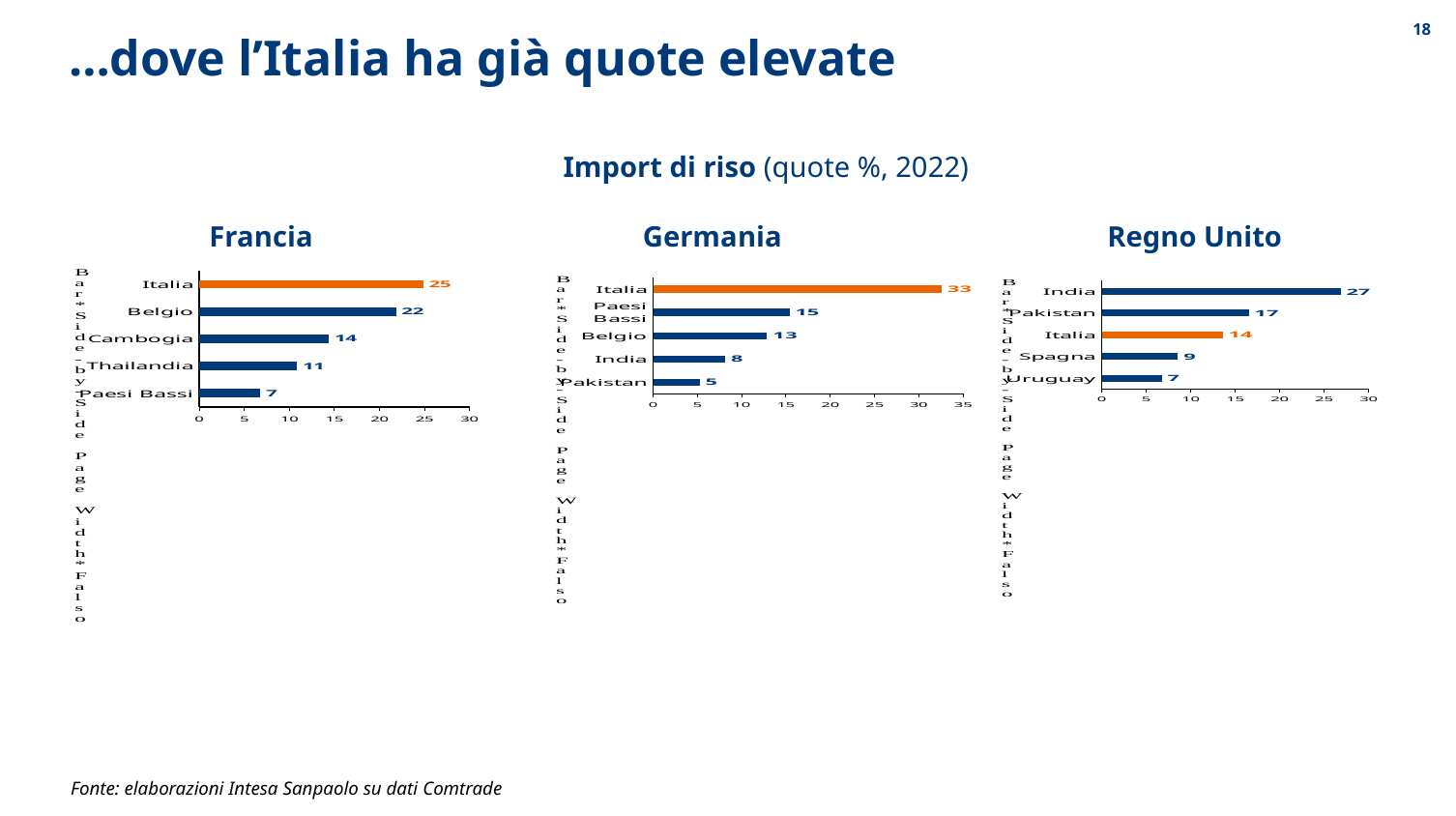
What kind of chart is the Germania chart? Bar chart In the Germania chart, which country has the lowest value? Pakistan In the Germania chart, what is the difference between the values for Italia and Pakistan? 28 In the Germania chart, which is larger, the value for Belgio or the value for India? Belgio In the Francia chart, what is the value for Italia? 25 In the Germania chart, what is the value for Paesi Bassi? 15 In the Regno Unito chart, is the value for Pakistan greater or less than 15? greater In the Regno Unito chart, what is the value for Italia? 14 In the Francia chart, which bar is coloured orange? Italia In the Regno Unito chart, which country has the highest value? India In the Francia chart, what is the difference between the values for Italia and Belgio? 3 How many countries are shown in the Francia chart? 5